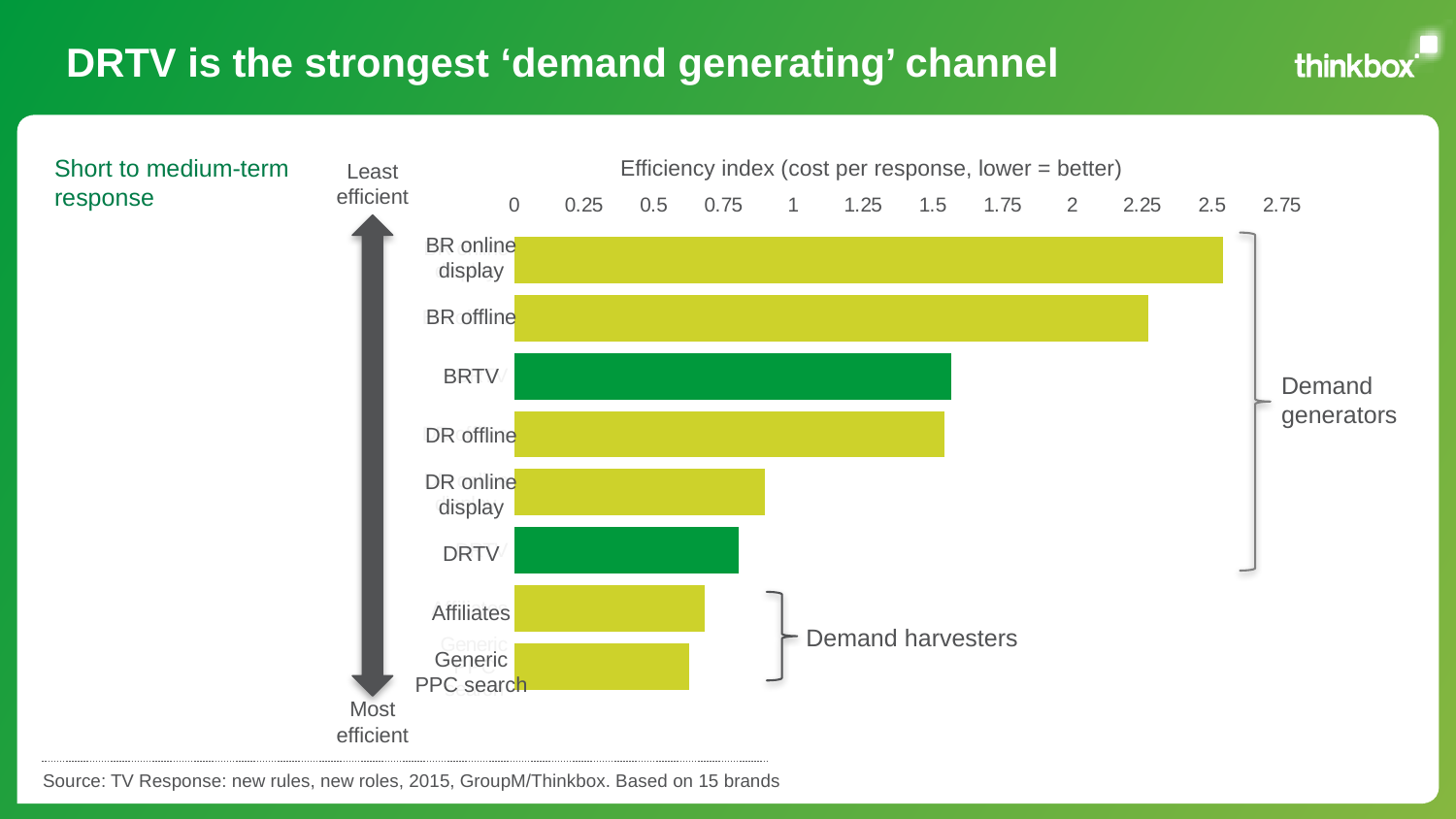
Which channel has the highest efficiency index (longest bar)? BR online display What is the title of the horizontal axis of the chart? Efficiency index (cost per response, lower = better) Is the efficiency index for DR offline greater or less than 1.25? greater Is the efficiency index for DR online display greater or less than 1? less Is the efficiency index for Affiliates greater or less than 0.75? less How many channels are grouped under the 'Demand harvesters' bracket? 2 How many channels (categories) are plotted in the chart? 8 Which has the larger efficiency index, BR offline or BRTV? BR offline What kind of chart is shown on the slide? bar chart